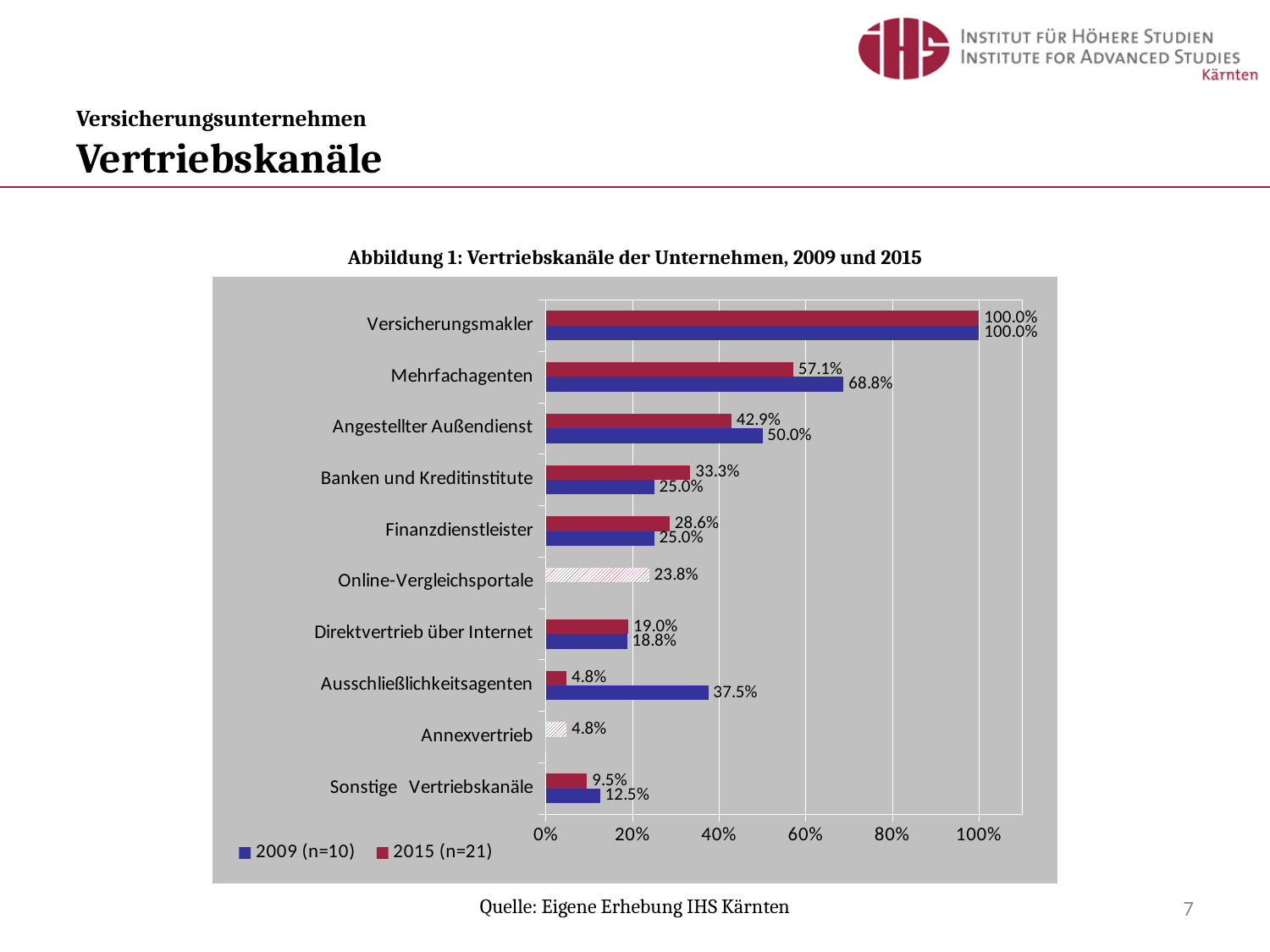
What is the difference between the 2009 (n=10) and 2015 (n=21) values for Mehrfachagenten? 11.7% Which is larger for Banken und Kreditinstitute: the 2009 (n=10) value or the 2015 (n=21) value? 2015 (n=21) What is the value for Ausschließlichkeitsagenten in the 2009 (n=10) series? 37.5% What is the value for Online-Vergleichsportale in 2015 (n=21)? 23.8% What is the value for Mehrfachagenten in the 2015 (n=21) series? 57.1% What is the value for Angestellter Außendienst in the 2009 (n=10) series? 50.0% Which category has the highest value in the 2009 (n=10) series? Versicherungsmakler What is the title of the chart? Abbildung 1: Vertriebskanäle der Unternehmen, 2009 und 2015 What kind of chart is shown on the slide? bar chart How many categories are shown on the y axis of the chart? 10 How many series does the legend list? 2